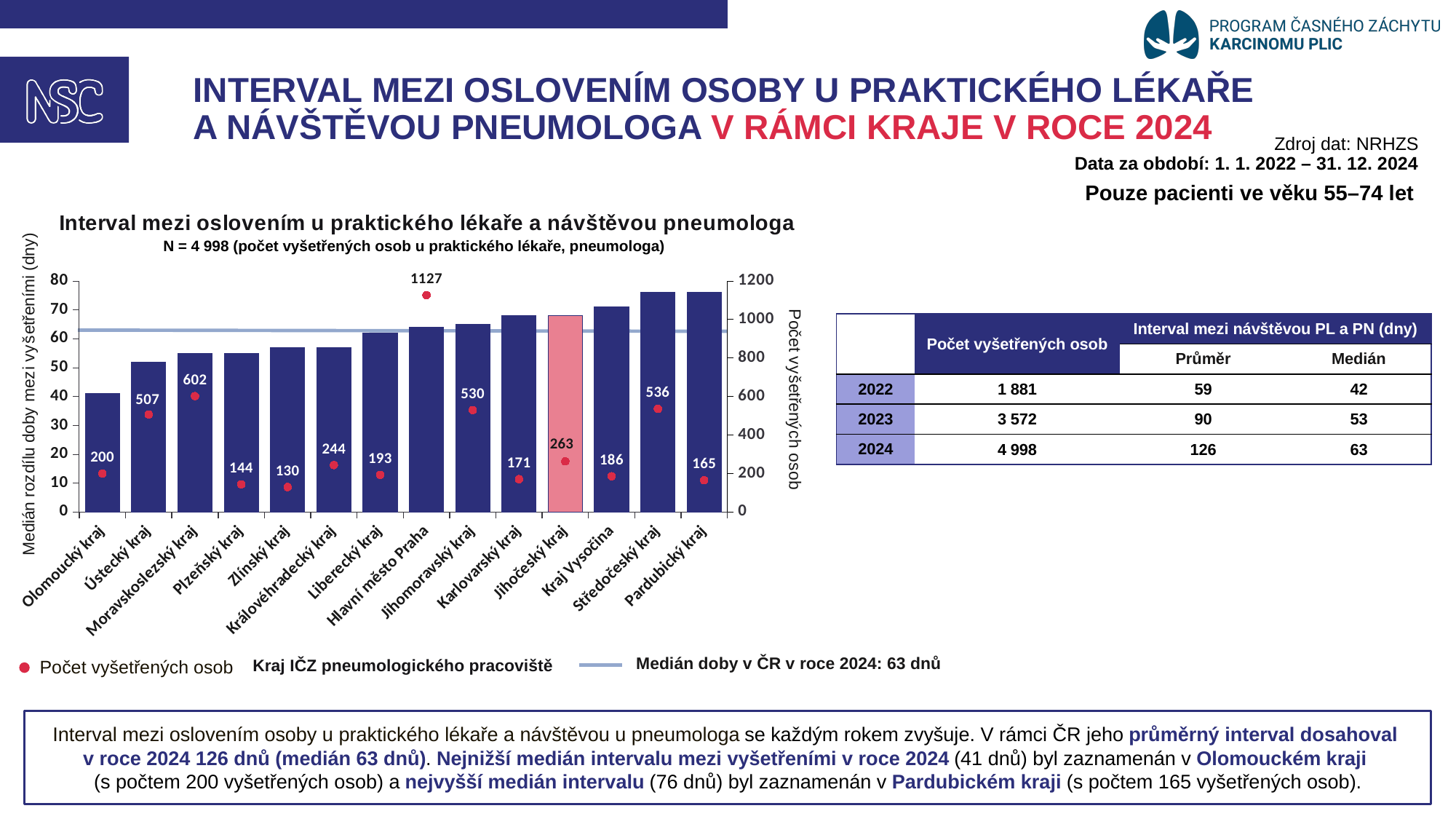
What value does the horizontal reference line in the chart represent, according to the legend? Medián doby v ČR v roce 2024: 63 dnů What is the number of examined persons shown for Jihočeský kraj? 263 Do the median interval bars rise or fall from left to right along the x axis? rise How many regions are shown on the x axis of the chart? 14 What is the difference between the number of examined persons in Moravskoslezský kraj and Ústecký kraj? 95 Which has more examined persons, Královéhradecký kraj or Liberecký kraj? Královéhradecký kraj Is the median interval bar for Pardubický kraj greater or less than 70 days? greater What is the number of examined persons shown for Olomoucký kraj? 200 Is the median interval bar for Olomoucký kraj greater or less than 50 days? less Which region has the highest number of examined persons? Hlavní město Praha What is the number of examined persons (Počet vyšetřených osob) for Hlavní město Praha? 1127 Which region has the lowest number of examined persons? Zlínský kraj